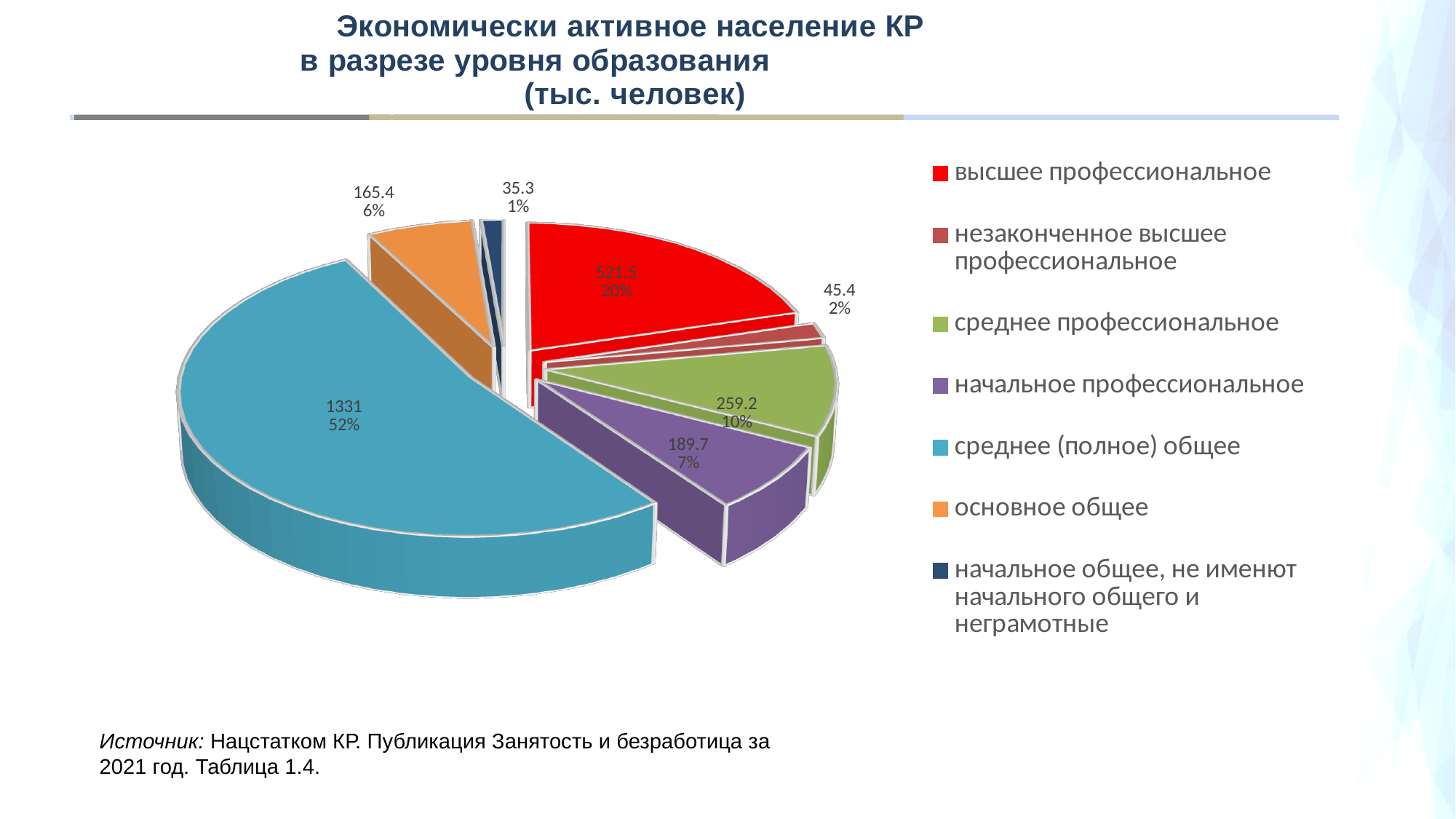
What kind of chart is shown on the slide? Pie chart What share of the pie does "основное общее" represent? 6% What is the value for "среднее (полное) общее"? 1331 What is the value for "среднее профессиональное"? 259.2 Which category has the largest slice of the pie? среднее (полное) общее What share of the pie does "незаконченное высшее профессиональное" represent? 2% What is the value for "начальное профессиональное"? 189.7 Which category has the smallest slice of the pie? начальное общее, не именют начального общего и неграмотные What is the value for "высшее профессиональное"? 521.5 How many categories does the legend of the pie chart list? 7 What is the difference between the values for "высшее профессиональное" and "среднее профессиональное"? 262.3 Which is larger, the value for "основное общее" or the value for "начальное профессиональное"? начальное профессиональное